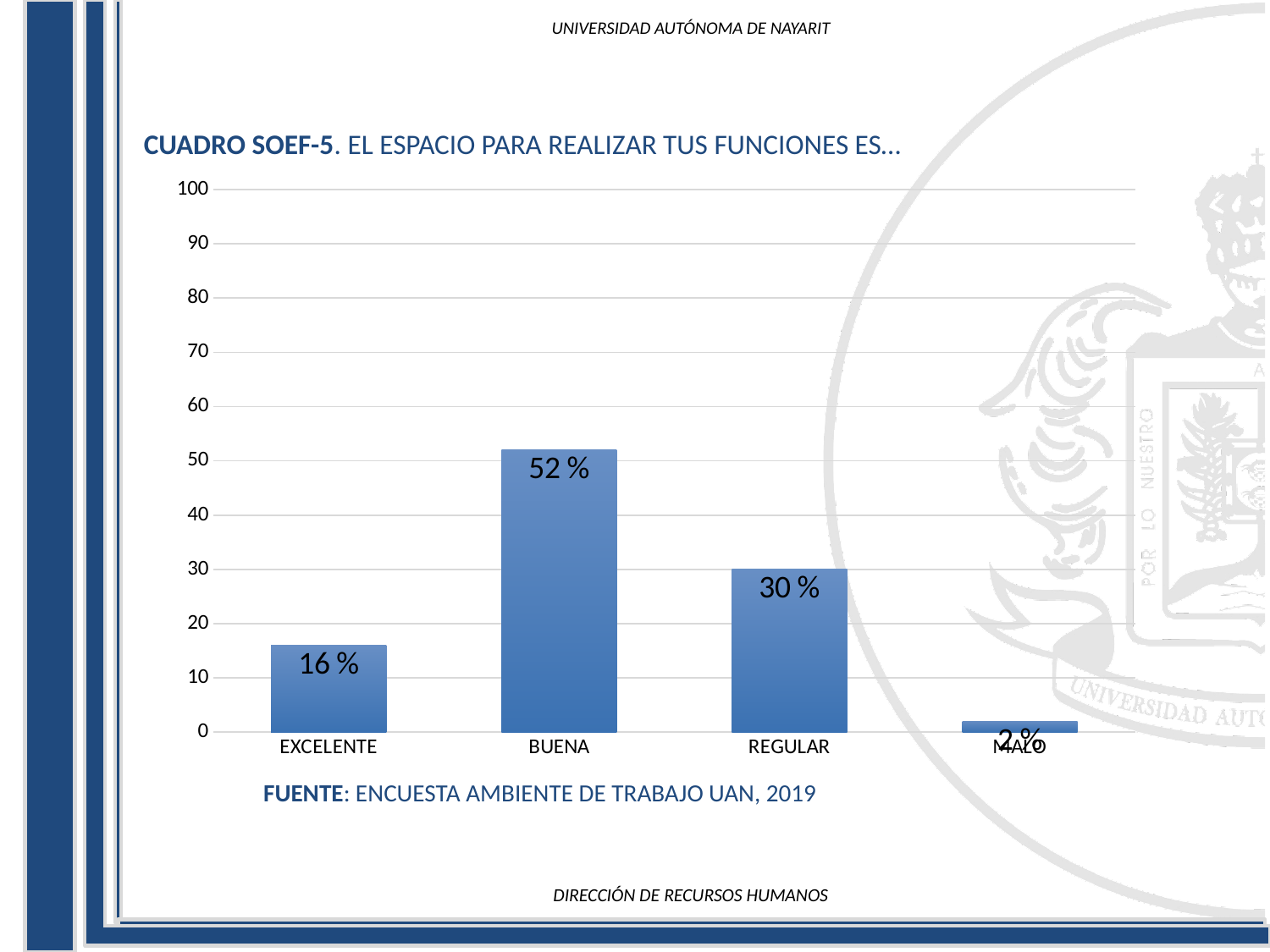
Which is larger, the value for EXCELENTE or the value for REGULAR? REGULAR Is the value for BUENA greater or less than 50? greater Which category has the highest value? BUENA What kind of chart is shown on the slide? bar chart How many categories are shown on the x axis? 4 What is the value for BUENA? 52 % Which category has the lowest value? MALO What is the value for EXCELENTE? 16 % What is the value for MALO? 2 % What is the difference between the values for BUENA and REGULAR? 22 % What is the value for REGULAR? 30 % What is the source cited below the chart? ENCUESTA AMBIENTE DE TRABAJO UAN, 2019